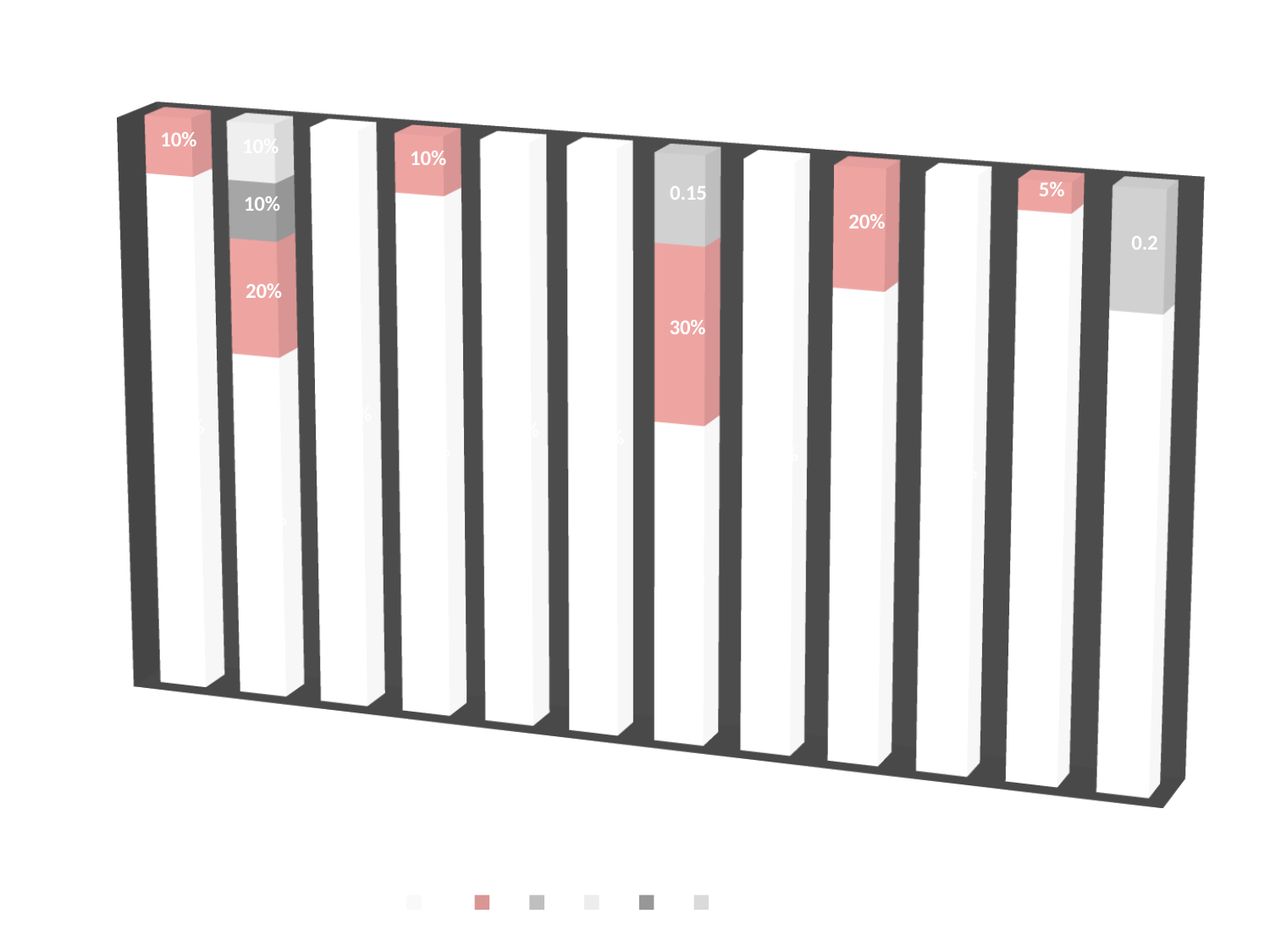
What value is labelled on the pink segment of the second bar from the left? 20% What value is labelled on the pink segment of the ninth bar from the left? 20% What kind of chart is shown on the slide? stacked bar chart How many bars are plotted in the chart? 12 What value is labelled on the pink segment of the eleventh bar from the left? 5% Which bar has the largest labelled pink segment? the seventh bar from the left (30%) What value is labelled on the pink segment of the seventh bar from the left? 30% How many series does the legend at the bottom of the chart list? 6 What is the difference between the pink segment of the seventh bar (30%) and the pink segment of the ninth bar (20%)? 10% What value is labelled on the grey segment at the top of the seventh bar from the left? 0.15 What value is labelled on the grey segment at the top of the rightmost bar? 0.2 What value is labelled on the pink segment at the top of the first bar from the left? 10%